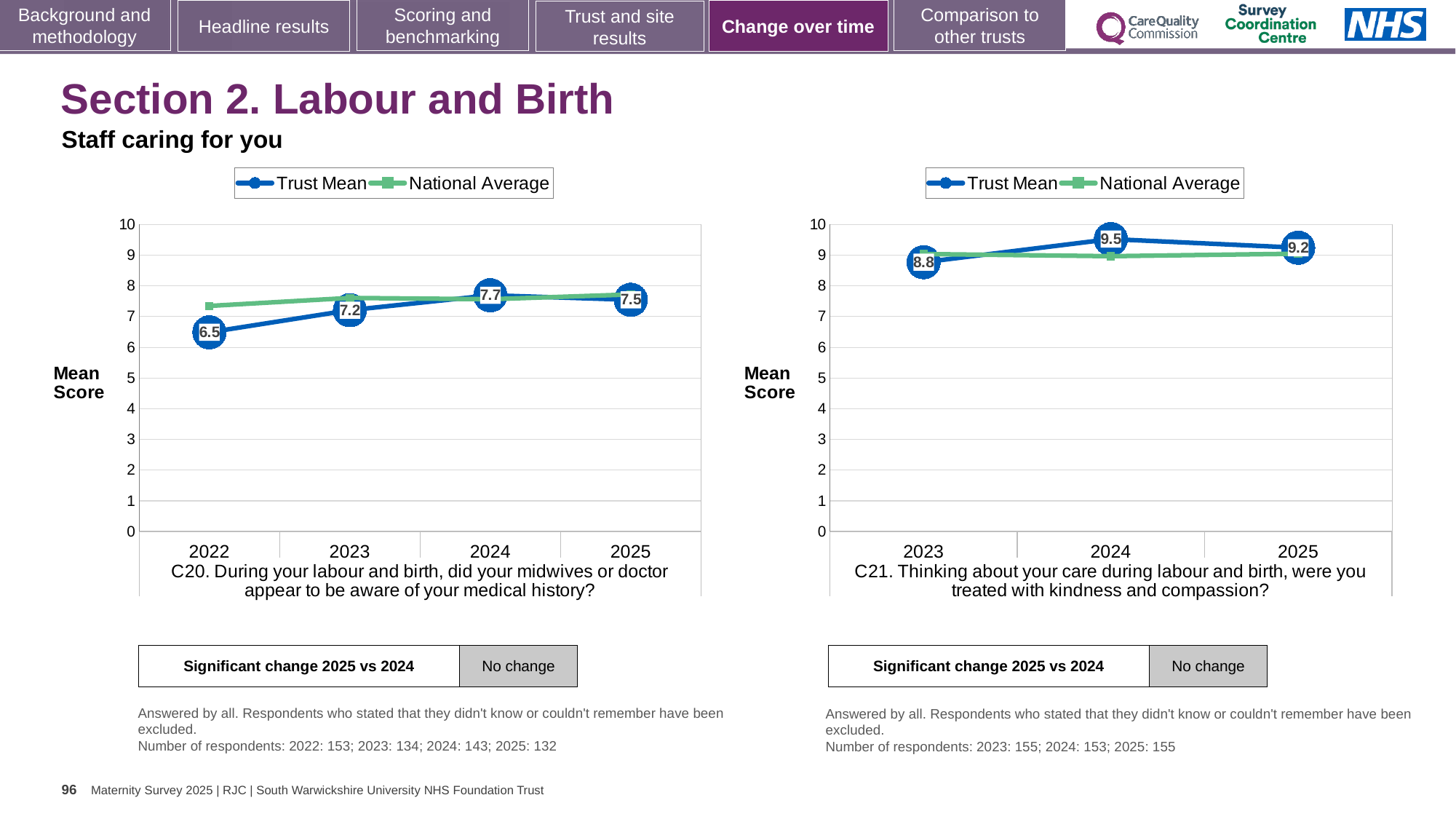
In the C20 chart (left), what is the Trust Mean score for 2022? 6.5 In the C20 chart (left), which year has the lowest Trust Mean score? 2022 In the C20 chart (left), what is the Trust Mean score for 2024? 7.7 In the C21 chart (right), is the Trust Mean score for 2023 greater or less than the score for 2024? less In the C21 chart (right), what is the Trust Mean score for 2025? 9.2 In the C21 chart (right), how many series does the legend list? 2 What type of chart is the C20 chart on the left? Line chart In the C20 chart (left), what is the difference between the Trust Mean scores for 2023 and 2022? 0.7 In the C21 chart (right), which year has the lowest Trust Mean score? 2023 In the C21 chart (right), what is the Trust Mean score for 2024? 9.5 In the C20 chart (left), which year has the highest Trust Mean score? 2024 In the C20 chart (left), how many years are shown on the x axis? 4